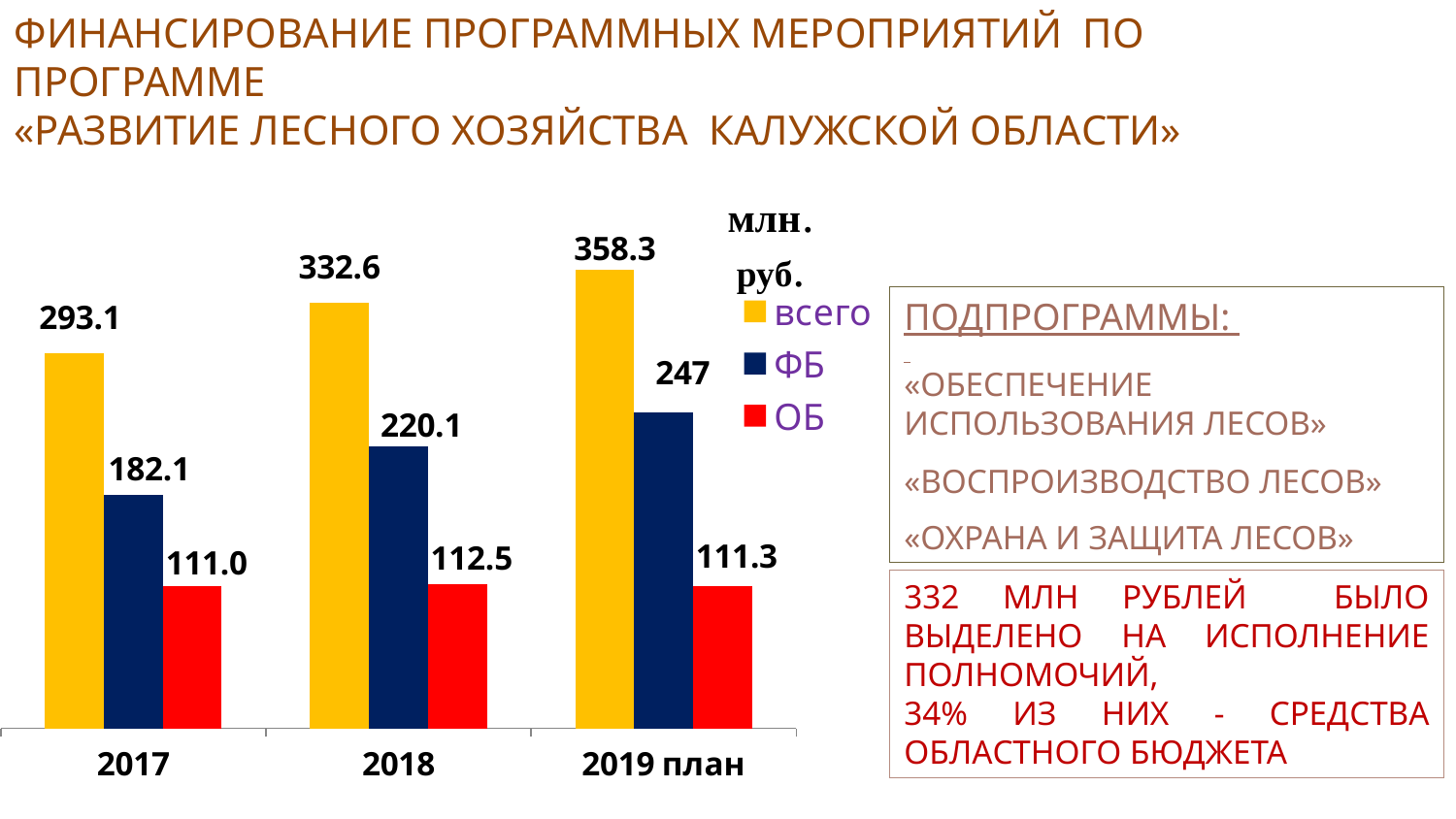
What kind of chart is shown on the slide? bar chart How many series does the legend list? 3 Which is larger, the ОБ value for 2018 or the ОБ value for 2019 план? 2018 What is the difference between the всего values for 2019 план and 2017? 65.2 What is the difference between the ФБ values for 2018 and 2017? 38.0 Does the всего value rise or fall from 2017 to 2019 план? rise What is the value of всего for 2018? 332.6 In which year is the всего value highest? 2019 план How many years (categories) are shown on the x axis? 3 In which year is the ФБ value lowest? 2017 What is the value of ФБ for 2019 план? 247 What is the value of ОБ for 2017? 111.0